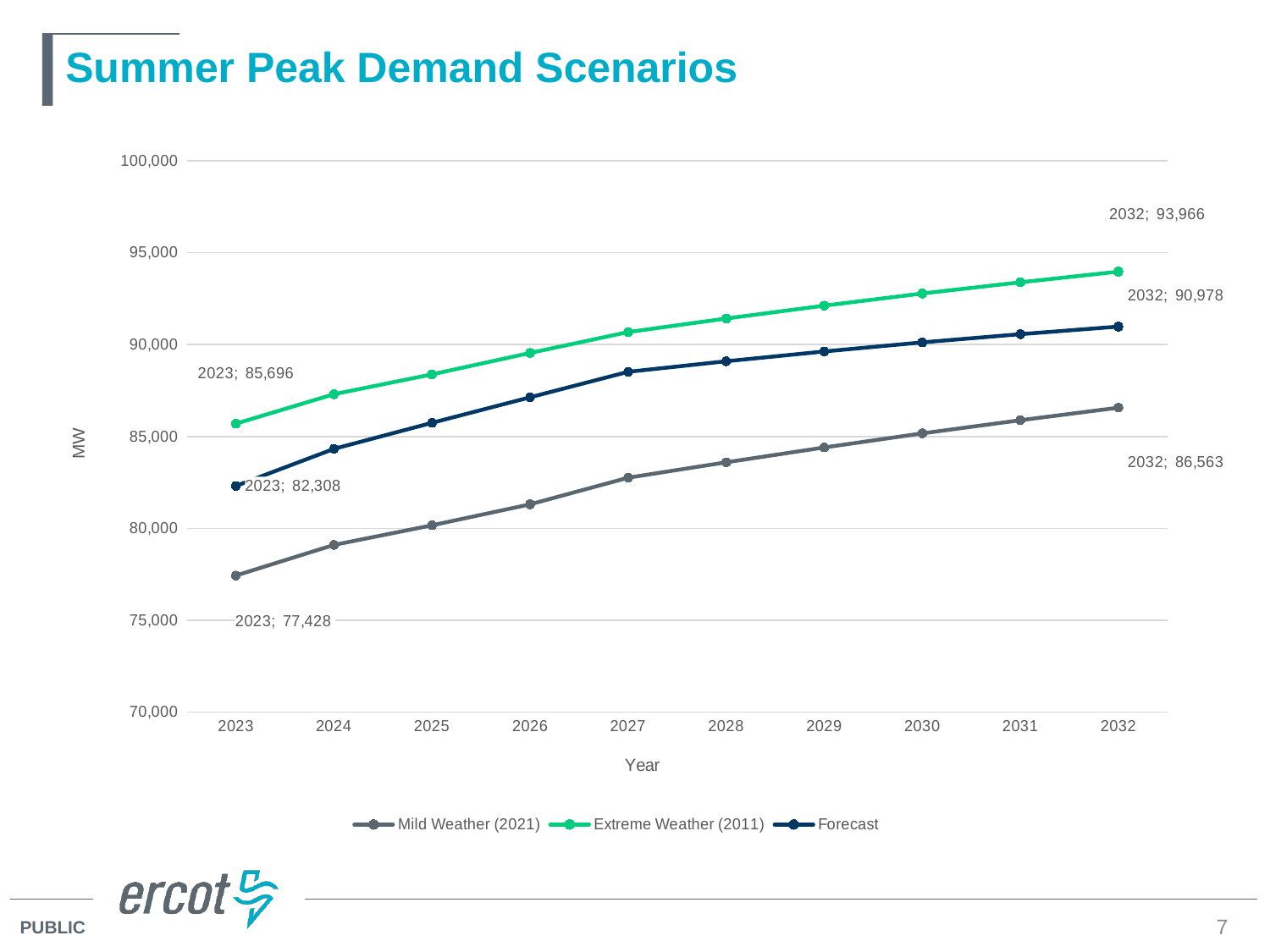
What is the Forecast value in 2023? 82,308 What is the difference between the Extreme Weather (2011) and Forecast values in 2032? 2,988 By how much does the Forecast value increase from 2023 to 2032? 8,670 How many series does the legend list? 3 Is the Forecast value in 2027 greater or less than 85,000? greater Which series has the highest value in 2032? Extreme Weather (2011) What is the Mild Weather (2021) value in 2032? 86,563 What is the title of the chart? Summer Peak Demand Scenarios What is the Extreme Weather (2011) value in 2032? 93,966 How many years are shown on the x axis? 10 What is the Mild Weather (2021) value in 2023? 77,428 What type of chart is shown on the slide? Line chart